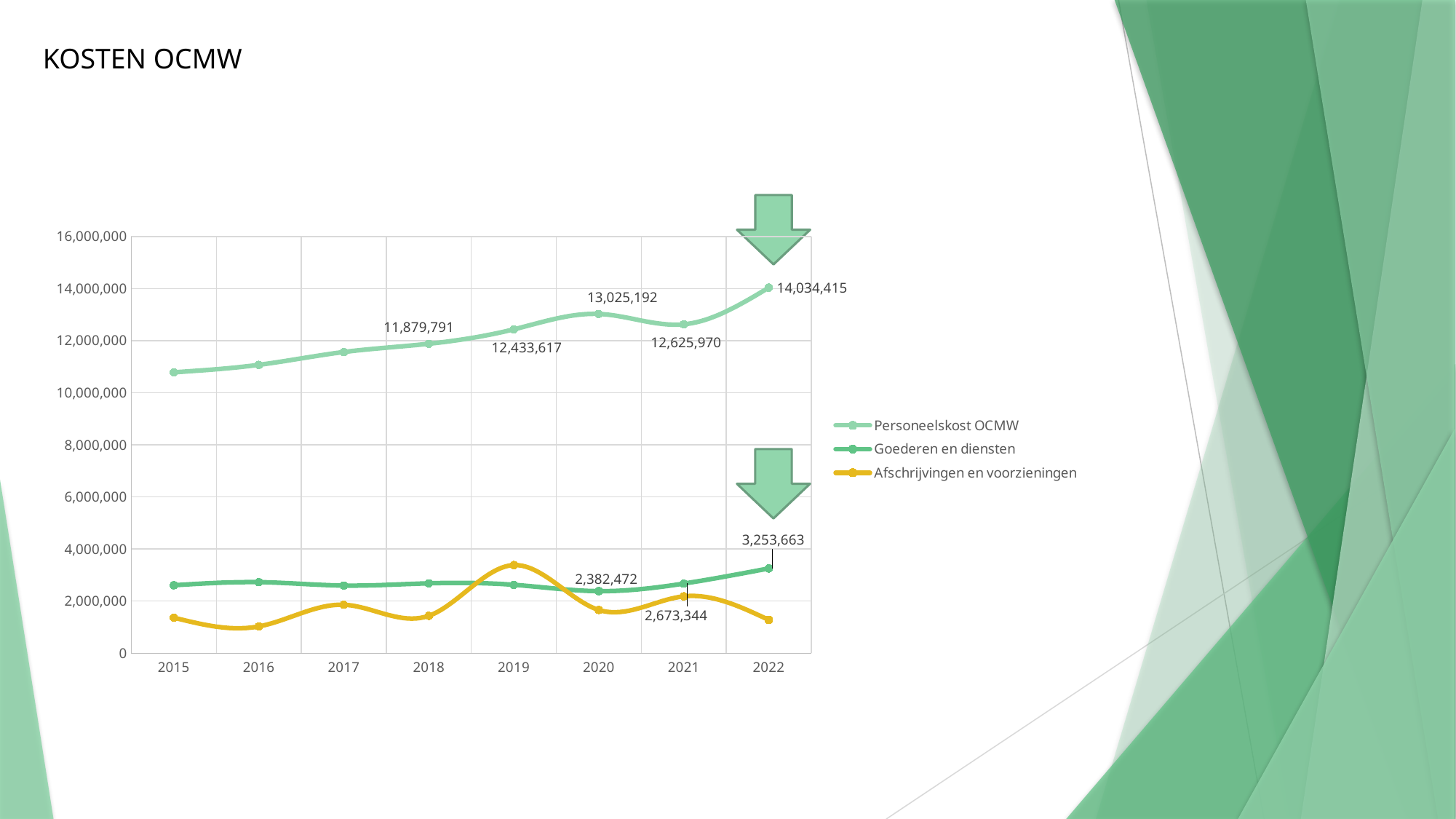
How many years are shown on the x axis? 8 What kind of chart is shown on the slide? line chart Is the value for Afschrijvingen en voorzieningen in 2019 greater or less than 4,000,000? less Which is larger, Personeelskost OCMW in 2020 or in 2021? 2020 What is the value of Goederen en diensten in 2022? 3,253,663 What is the value of Personeelskost OCMW in 2022? 14,034,415 How many series does the legend list? 3 What is the difference between Personeelskost OCMW in 2022 and in 2021? 1,408,445 What is the difference between Goederen en diensten in 2022 and in 2020? 871,191 What is the value of Personeelskost OCMW in 2018? 11,879,791 In which year is Personeelskost OCMW highest? 2022 What is the value of Goederen en diensten in 2021? 2,673,344